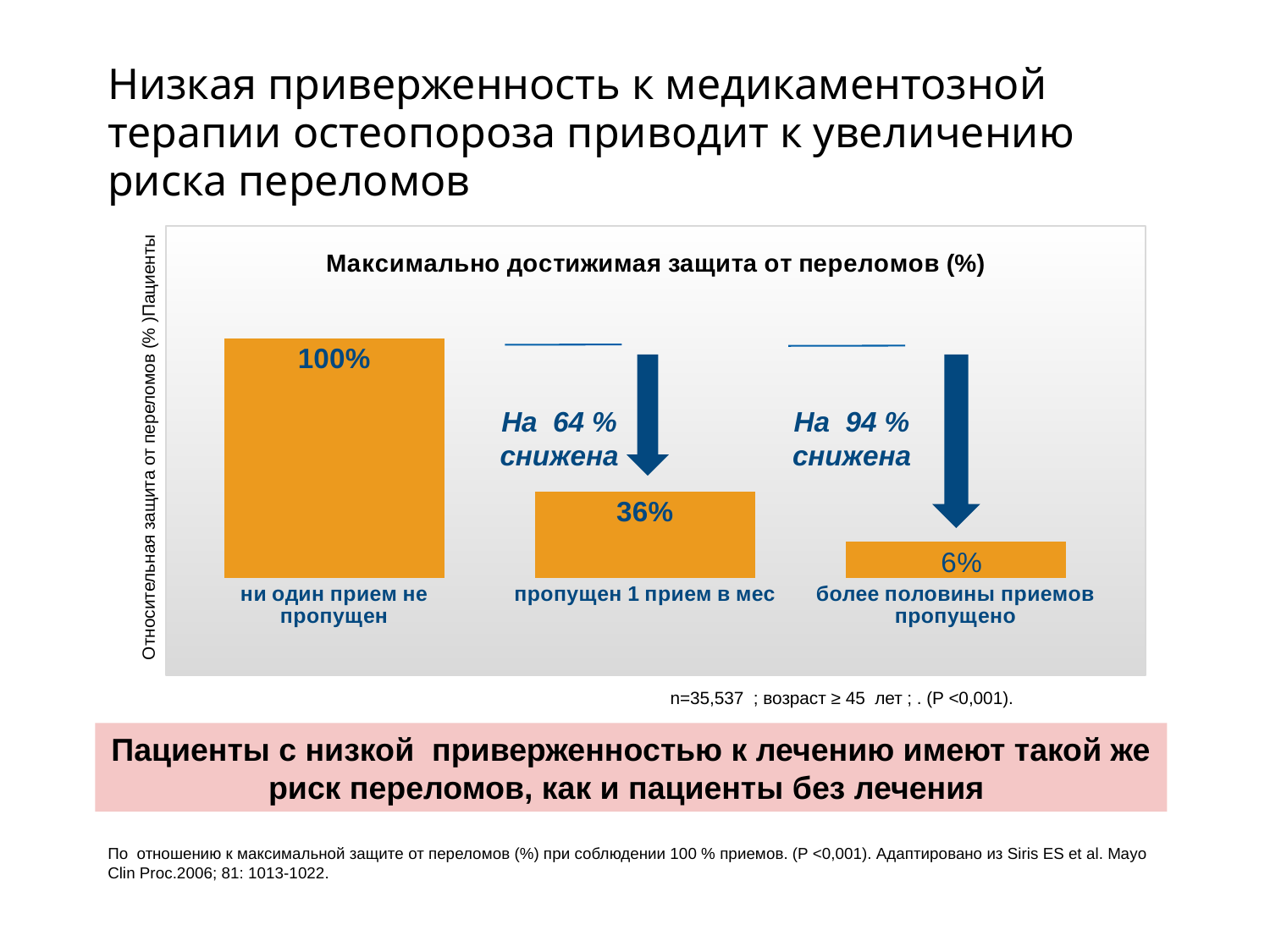
Какая категория имеет наименьшее значение на диаграмме? более половины приемов пропущено Какое значение показано для категории «ни один прием не пропущен»? 100% Какое значение показано для категории «пропущен 1 прием в мес»? 36% Сколько категорий показано на диаграмме? 3 Какая категория имеет наибольшее значение на диаграмме? ни один прием не пропущен На сколько процентных пунктов значение для «пропущен 1 прием в мес» больше, чем для «более половины приемов пропущено»? 30 На сколько процентных пунктов значение для «ни один прием не пропущен» больше, чем для «пропущен 1 прием в мес»? 64 Как называется диаграмма? Максимально достижимая защита от переломов (%) Как изменяются значения слева направо по оси x? Снижаются Какого типа эта диаграмма? Столбчатая (bar chart) Какое значение показано для категории «более половины приемов пропущено»? 6% Какое значение больше: для «пропущен 1 прием в мес» или для «более половины приемов пропущено»? пропущен 1 прием в мес